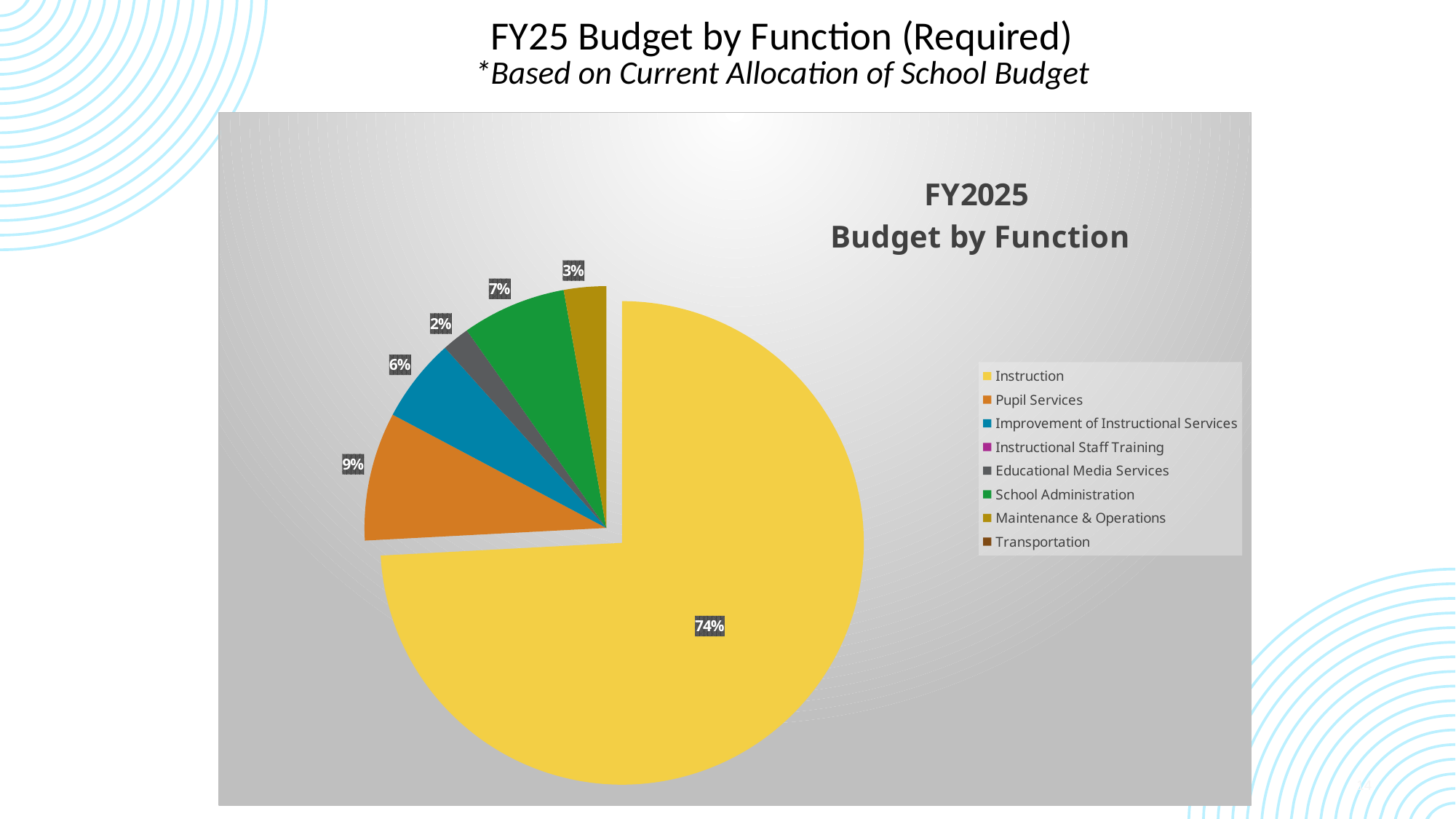
What percentage is shown for Educational Media Services? 2% What percentage of the budget goes to Pupil Services? 9% What percentage is shown for Maintenance & Operations? 3% How many entries does the legend list? 8 What percentage is shown for Improvement of Instructional Services? 6% What share of the FY2025 Budget by Function pie chart is Instruction? 74% What percentage is shown for School Administration? 7% What type of chart is shown on the slide? Pie chart Which function has the largest share of the budget? Instruction Which is larger, the share for Pupil Services or the share for School Administration? Pupil Services What is the difference in percentage points between Instruction and Pupil Services? 65 What is the title shown inside the chart area? FY2025 Budget by Function